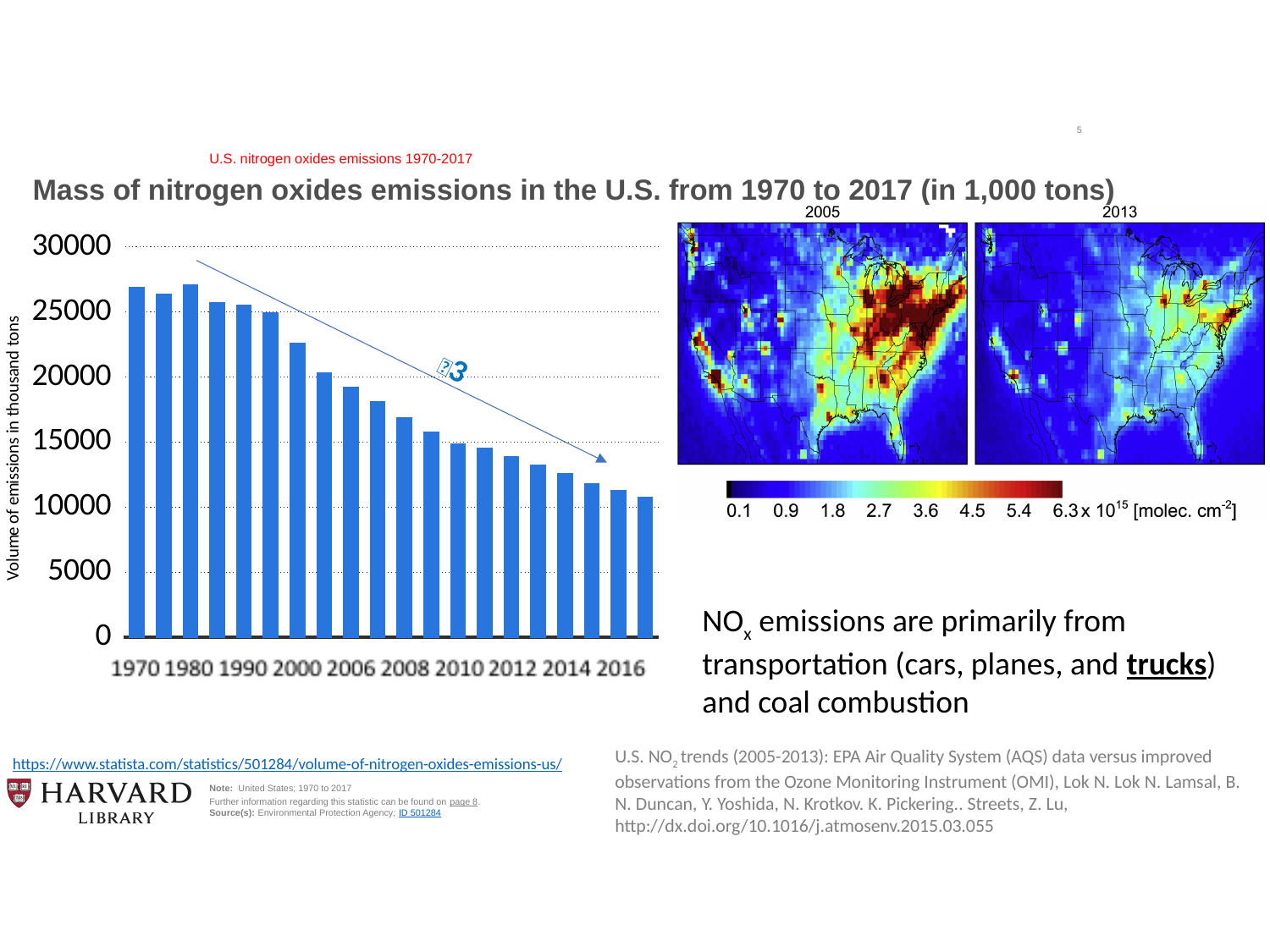
In the bar chart of nitrogen oxides emissions, is the value for 2008 greater or less than 15000? greater In the bar chart of nitrogen oxides emissions, is the value for 1970 greater or less than 25000? greater In the bar chart of nitrogen oxides emissions, do the values generally rise or fall from 1970 to 2017? Fall In the bar chart of nitrogen oxides emissions, is the value for 2014 greater or less than 15000? less What kind of chart is used to show the mass of nitrogen oxides emissions in the U.S. from 1970 to 2017? Bar chart What is the label on the vertical axis of the bar chart of nitrogen oxides emissions? Volume of emissions in thousand tons In the bar chart of nitrogen oxides emissions, which year has the larger value, 1970 or 2016? 1970 What unit is used for the values in the bar chart of nitrogen oxides emissions, according to its title? 1,000 tons In the bar chart of nitrogen oxides emissions, which year has the larger value, 2000 or 2012? 2000